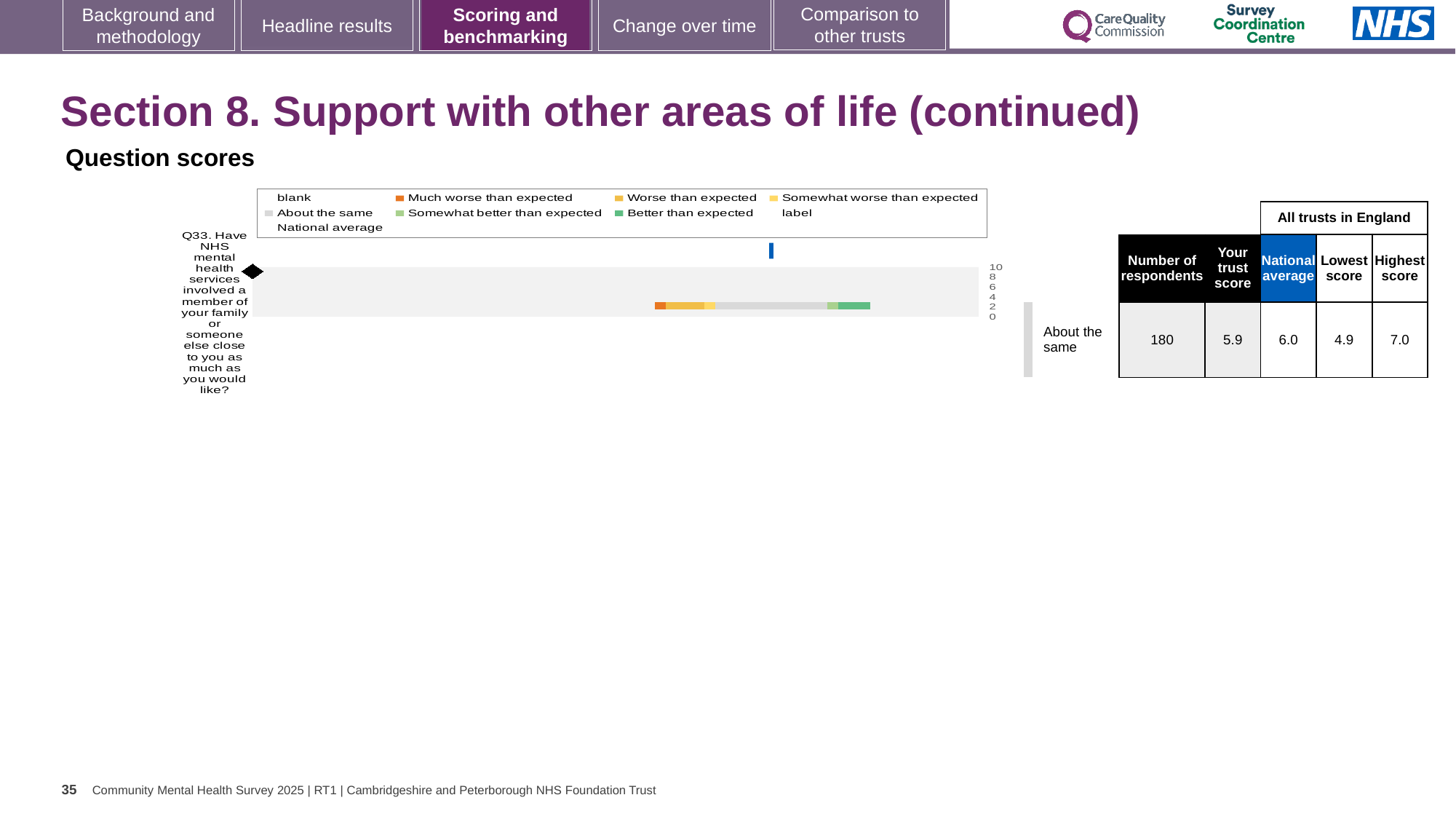
What is the trust's score for Q33? 5.9 Which legend entry is shown in dark green? Better than expected What is the lowest score among all trusts in England for Q33? 4.9 What is the number of respondents for Q33? 180 What is the highest score among all trusts in England for Q33? 7.0 What is the national average score for Q33? 6.0 What is the maximum value shown on the chart's score axis? 10 What is the difference between the highest and lowest trust scores for Q33? 2.1 How many questions are plotted on the chart? 1 What kind of chart is used to show the Q33 question score? bar chart Which is larger for Q33, the trust's score or the national average? the national average How is the trust's Q33 score categorised relative to expectations? About the same